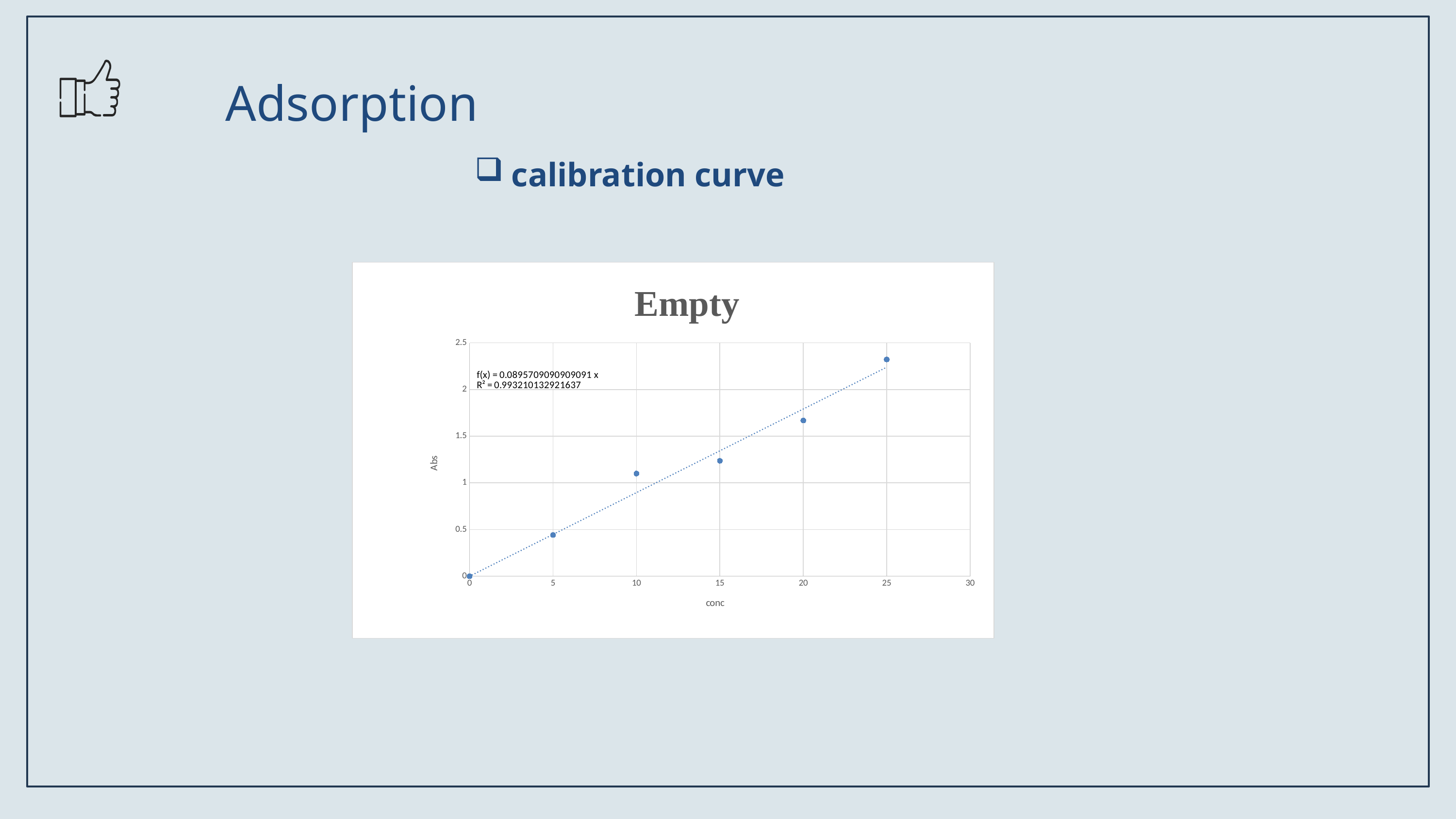
Is the Abs value at conc 20 greater or less than 1.5? greater What is the title of the chart? Empty Do the Abs values rise or fall as conc increases along the x axis? rise At which conc value is the Abs value highest? 25 What is the label of the x axis of the chart? conc Which has the larger Abs value: conc 15 or conc 20? conc 20 Is the Abs value at conc 25 greater or less than 2? greater What kind of chart is shown on the slide? scatter chart Is the Abs value at conc 5 greater or less than 0.5? less How many data points are plotted on the chart? 6 At which conc value is the Abs value lowest? 0